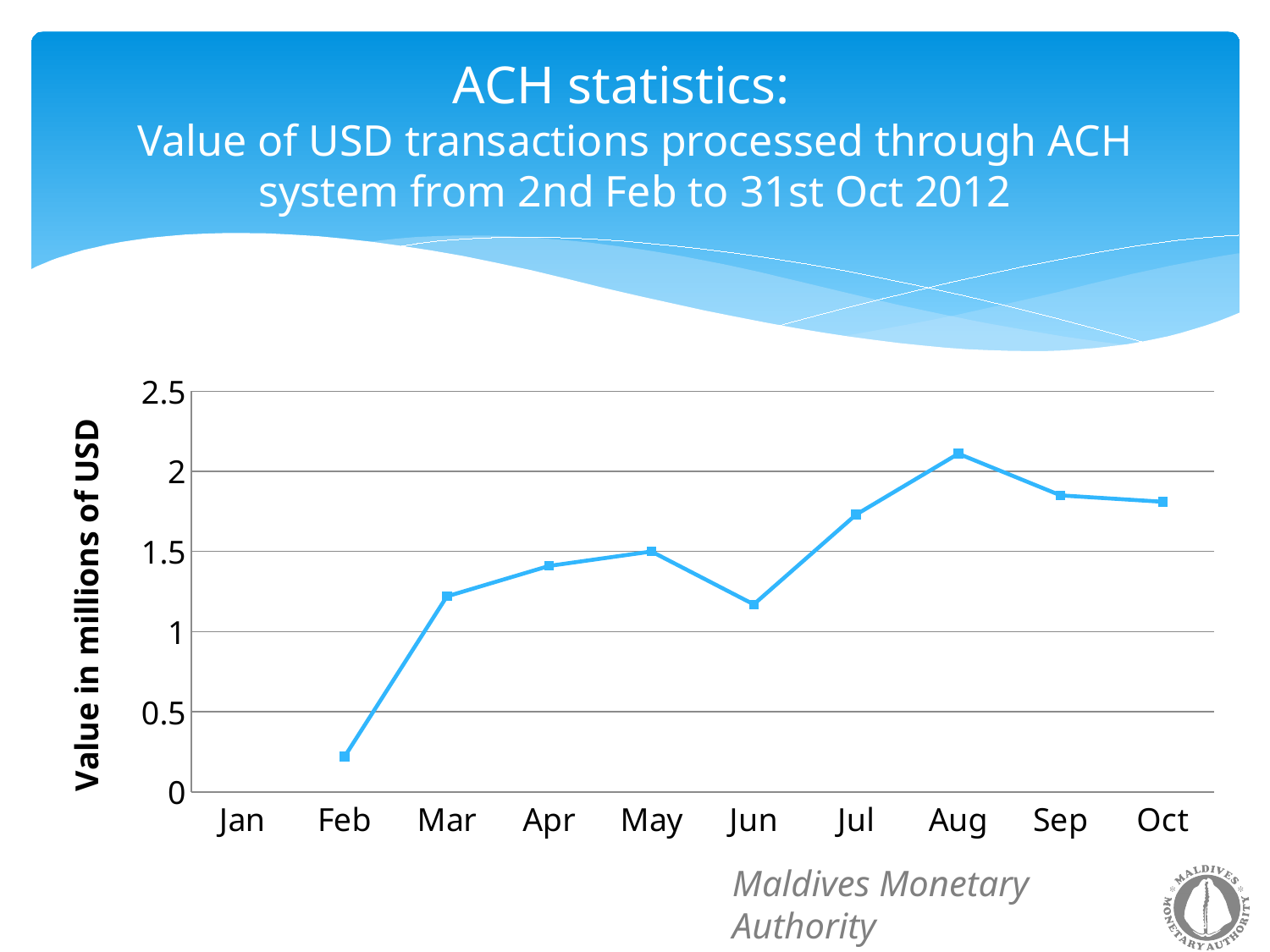
Which is larger, the value for May or the value for Jun? May Is the value for Jun greater or less than 1? greater Is the value for Aug greater or less than 2? greater Is the value for Feb greater or less than 0.5? less What kind of chart is shown on the slide? line chart Which month has the lowest plotted value of USD transactions? Feb Which is larger, the value for Aug or the value for Sep? Aug Does the value rise or fall from Feb to May? rise How many months are labelled on the x axis? 10 Which month has the highest value of USD transactions? Aug